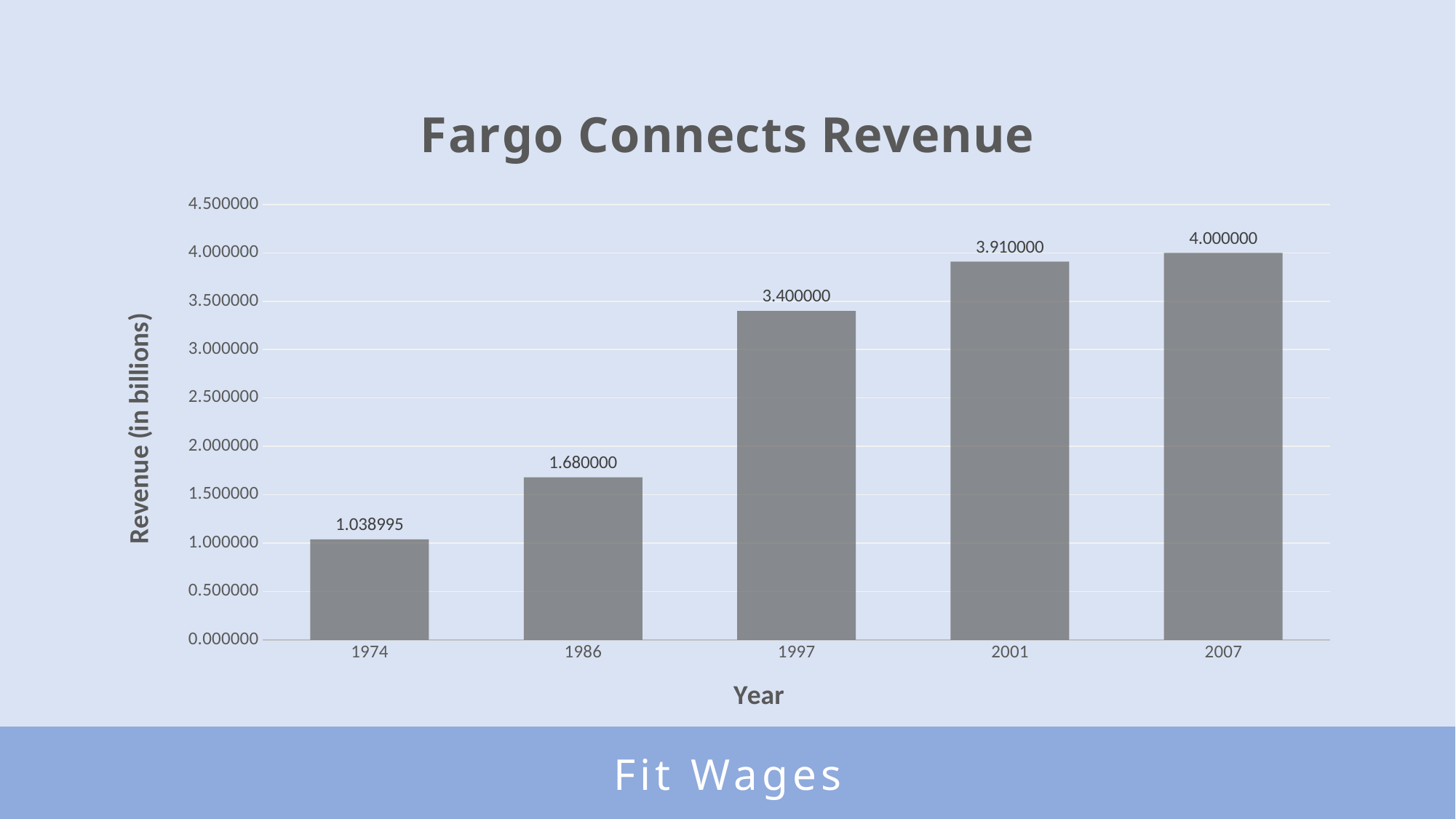
What is the revenue value shown for 1974? 1.038995 Which year has the larger revenue, 1986 or 1997? 1997 Which year has the highest revenue? 2007 Do the revenue values rise or fall from 1974 to 2007? Rise Is the value for 2001 greater or less than 3.500000? greater What is the difference between the revenue in 2001 and the revenue in 1986? 2.230000 What is the title of the chart? Fargo Connects Revenue What kind of chart is shown on the slide? Bar chart How many years are shown on the x axis? 5 What is the revenue value shown for 1997? 3.400000 Which year has the lowest revenue? 1974 What is the revenue value shown for 2007? 4.000000